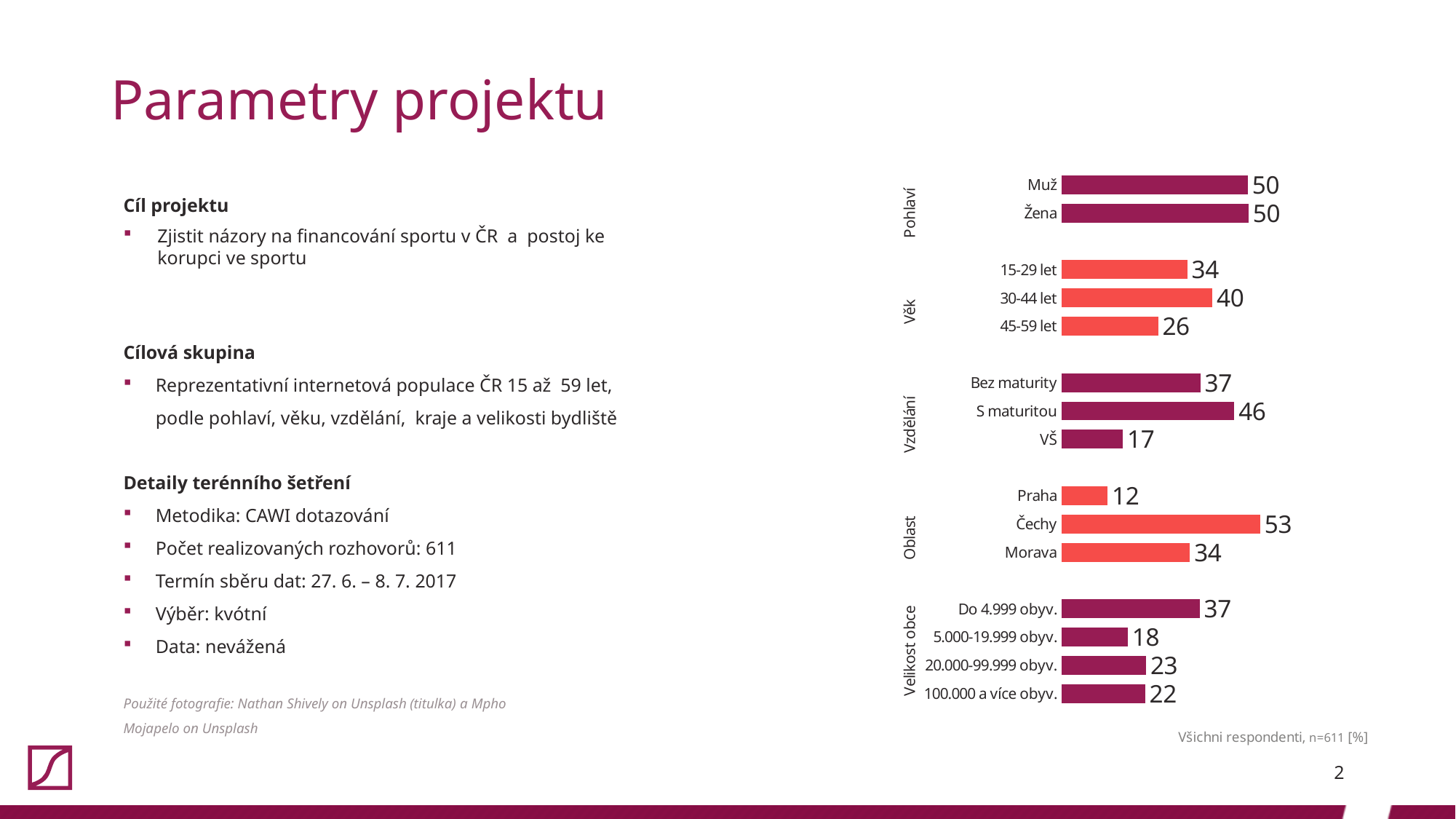
How many categories are plotted in the chart in total? 15 What is the value for Muž in the chart? 50 What is the value for 30-44 let in the chart? 40 Which category has the lowest value in the whole chart? Praha What is the value for 20.000-99.999 obyv. in the chart? 23 What is the total of the values for Muž and Žena? 100 Which category in the Věk group has the lowest value? 45-59 let What kind of chart is shown on the slide? Bar chart What is the difference between the values for S maturitou and Bez maturity? 9 What is the value for VŠ in the chart? 17 Which is larger, the value for Morava or the value for Praha? Morava Which category in the Oblast group has the highest value? Čechy